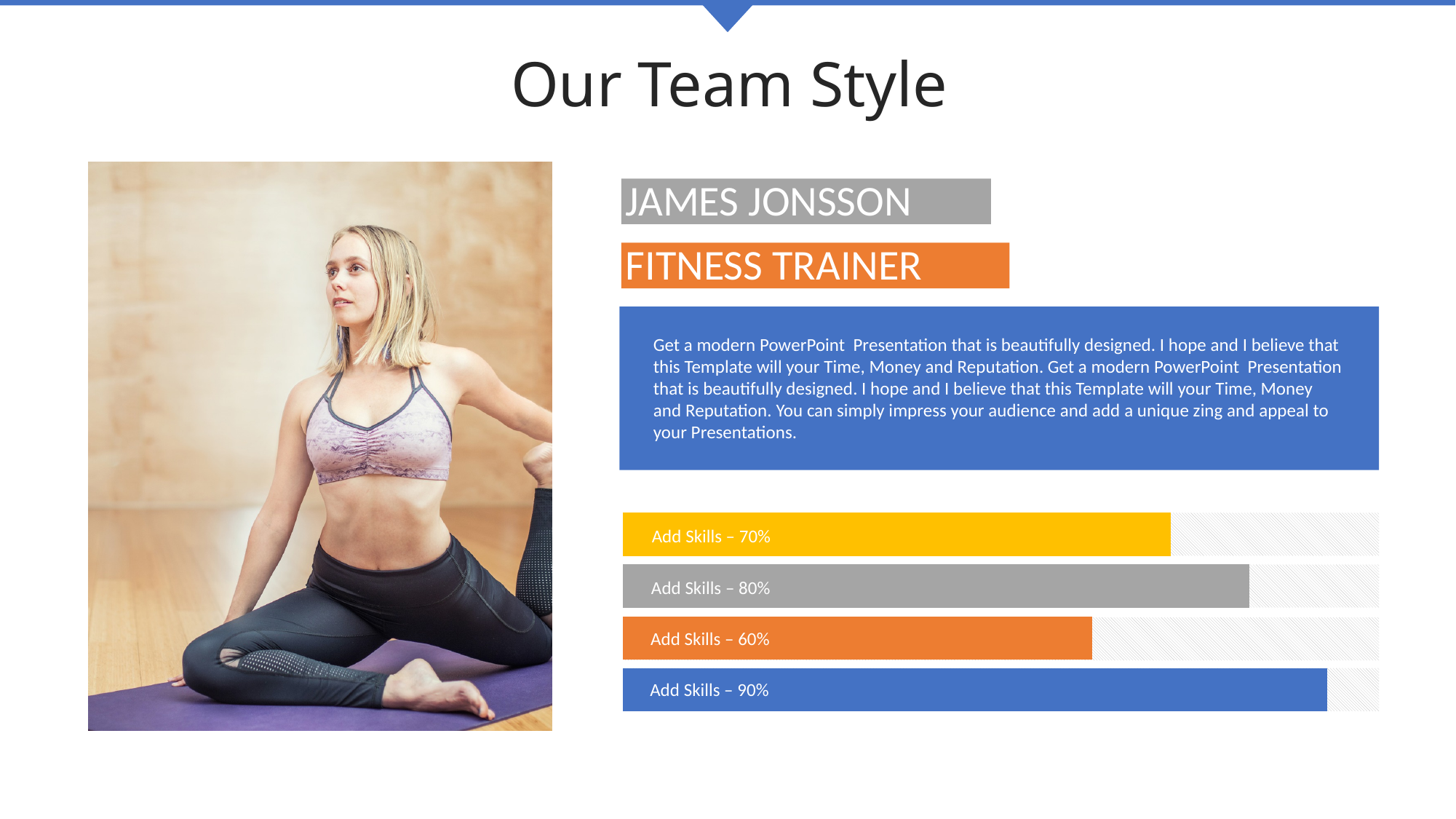
Which bar in the skills chart has the lowest value? the orange bar (60%) What colour is the bar showing 90% in the skills chart? blue What value is shown on the bottom (blue) bar of the skills chart? 90% Which is larger in the skills chart, the yellow bar's value or the grey bar's value? the grey bar (80%) How many bars are in the skills bar chart? 4 What kind of chart is shown on the right side of the slide below the text box? bar chart What value is shown on the first (yellow) bar of the skills chart? 70% Which bar in the skills chart has the highest value? the blue bar (90%) What value is shown on the orange bar of the skills chart? 60% What is the difference between the grey bar's value and the yellow bar's value in the skills chart? 10% What value is shown on the second (grey) bar of the skills chart? 80% What is the difference between the blue bar's value and the orange bar's value in the skills chart? 30%